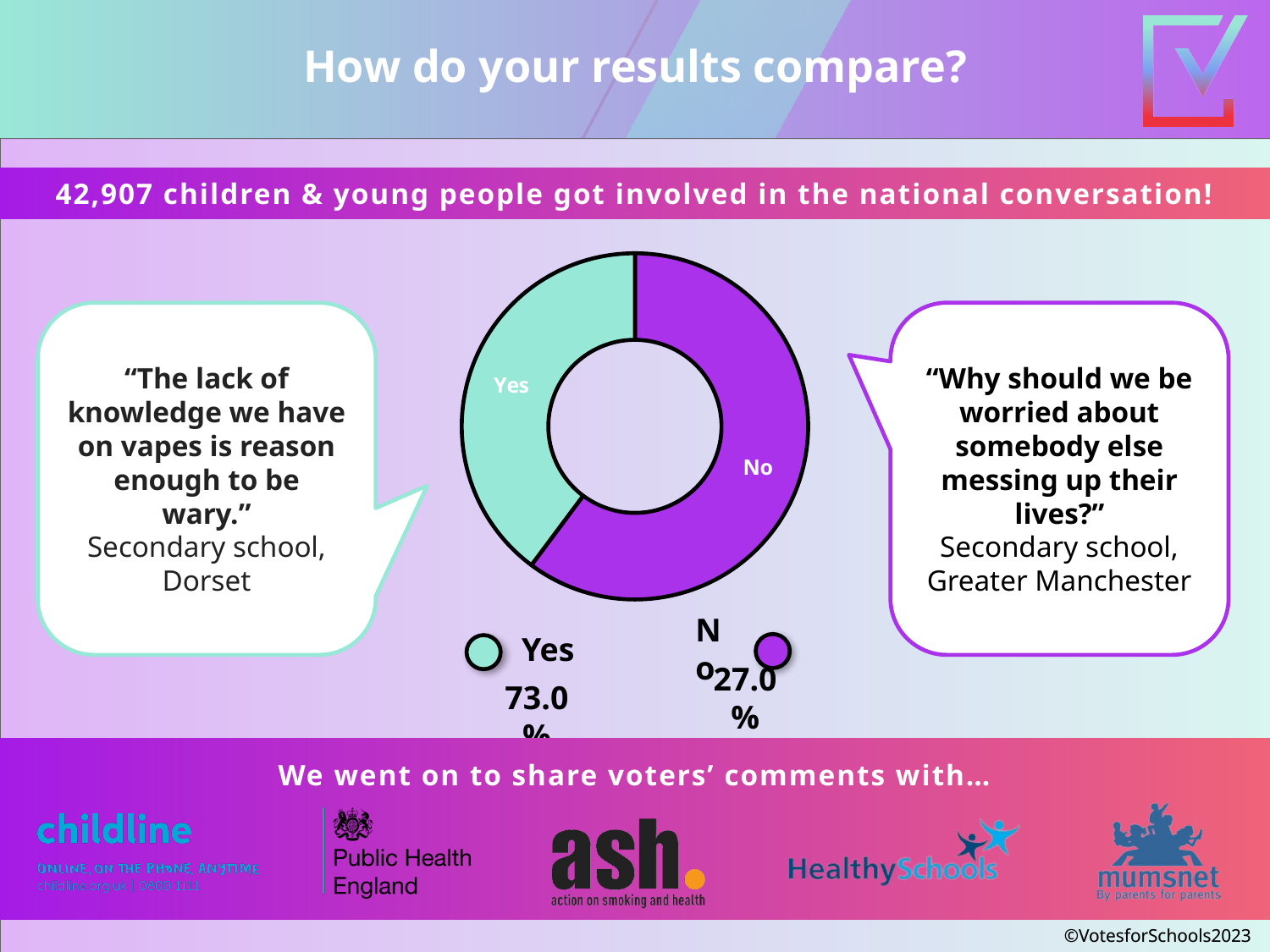
What is the total of the Yes and No percentages shown? 100.0% What colour represents the Yes category in the chart? Teal (light green) What is the difference in percentage points between the Yes and No shares? 46.0% How many entries does the legend list? 2 How many categories does the chart show? 2 What kind of chart is shown on the slide? Donut (pie) chart What percentage of respondents voted Yes? 73.0% What colour represents the No category in the chart? Purple What percentage of respondents voted No? 27.0%